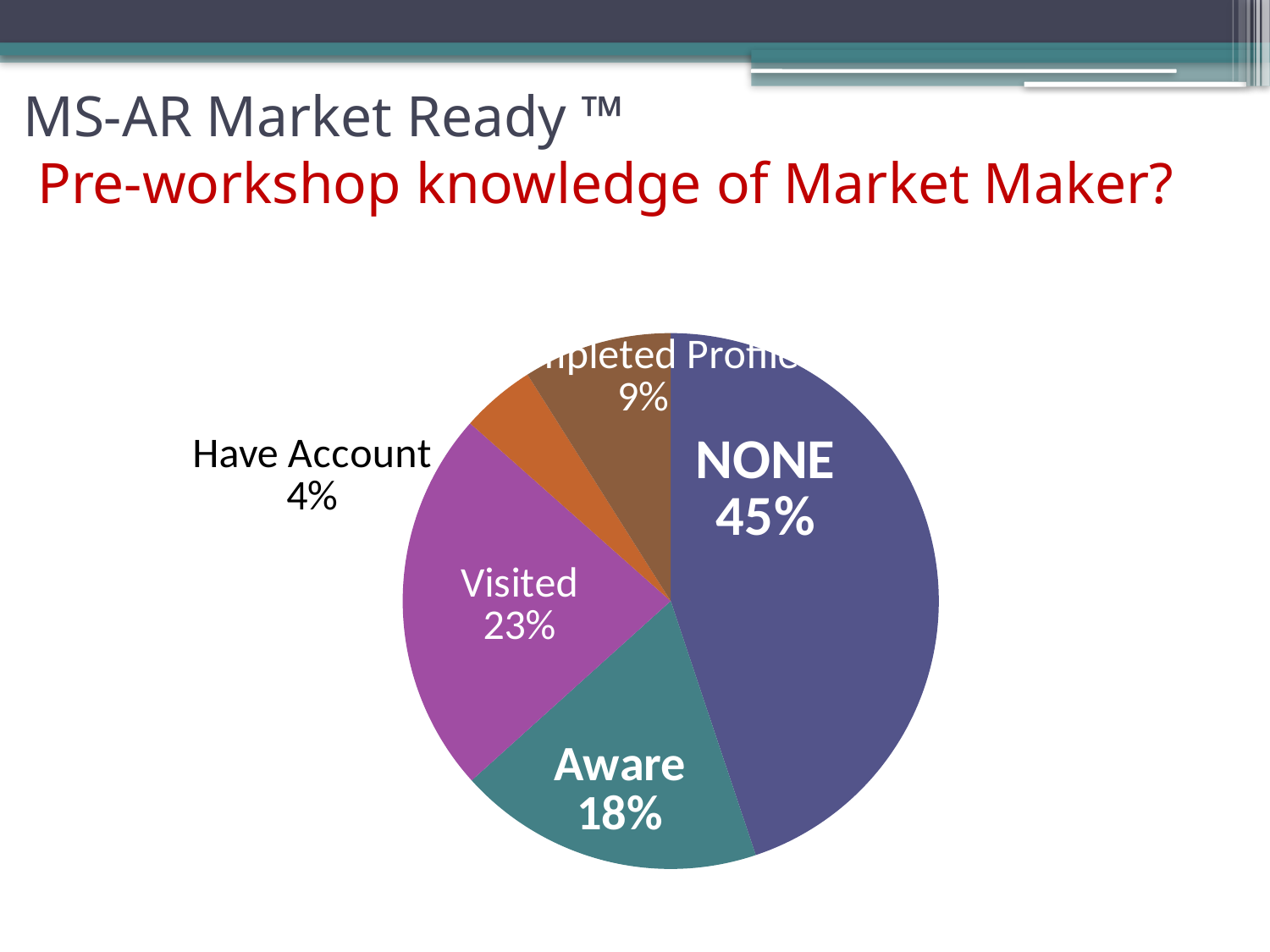
What percentage is shown for the Visited slice? 23% Which slice is larger, Visited or Aware? Visited What is the difference in percentage points between the NONE slice and the Aware slice? 27% What is the difference in percentage points between the Visited slice and the Have Account slice? 19% What percentage is shown for the Aware slice? 18% Which category has the smallest share of the pie? Have Account How many slices does the pie chart have? 5 Which category has the largest share of the pie? NONE What kind of chart is shown on the slide? pie chart What share of the pie does the NONE slice represent? 45% What percentage is shown for the Have Account slice? 4% What colour is the NONE slice of the pie chart? purple-blue